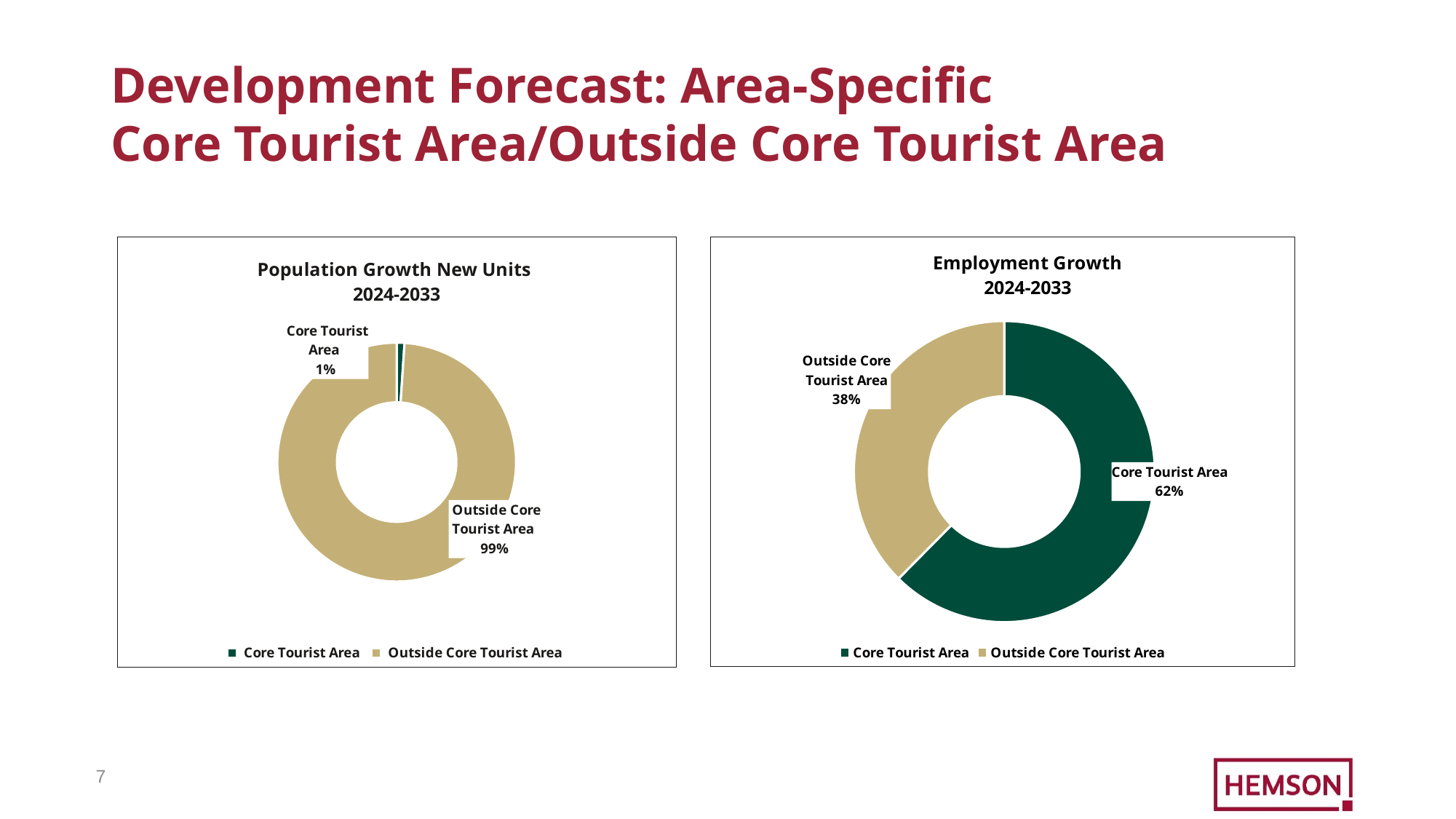
In the Employment Growth 2024-2033 chart, what share is labelled for Outside Core Tourist Area? 38% How many categories does the legend of the Employment Growth 2024-2033 chart list? 2 What kind of chart is the Population Growth New Units 2024-2033 chart? Doughnut (pie) chart In the Population Growth New Units 2024-2033 chart, what is the difference in percentage points between the Outside Core Tourist Area and Core Tourist Area shares? 98 In the Employment Growth 2024-2033 chart, what share is labelled for Core Tourist Area? 62% In the Population Growth New Units 2024-2033 chart, what share is labelled for Core Tourist Area? 1% In the Employment Growth 2024-2033 chart, which is larger: the Core Tourist Area share or the Outside Core Tourist Area share? Core Tourist Area In the Employment Growth 2024-2033 chart, what is the difference in percentage points between the Core Tourist Area and Outside Core Tourist Area shares? 24 In the Population Growth New Units 2024-2033 chart, what share is labelled for Outside Core Tourist Area? 99% In the Employment Growth 2024-2033 chart, which area has the largest share? Core Tourist Area In the Employment Growth 2024-2033 chart, what colour represents Core Tourist Area? Dark green In the Population Growth New Units 2024-2033 chart, which area has the smallest share? Core Tourist Area